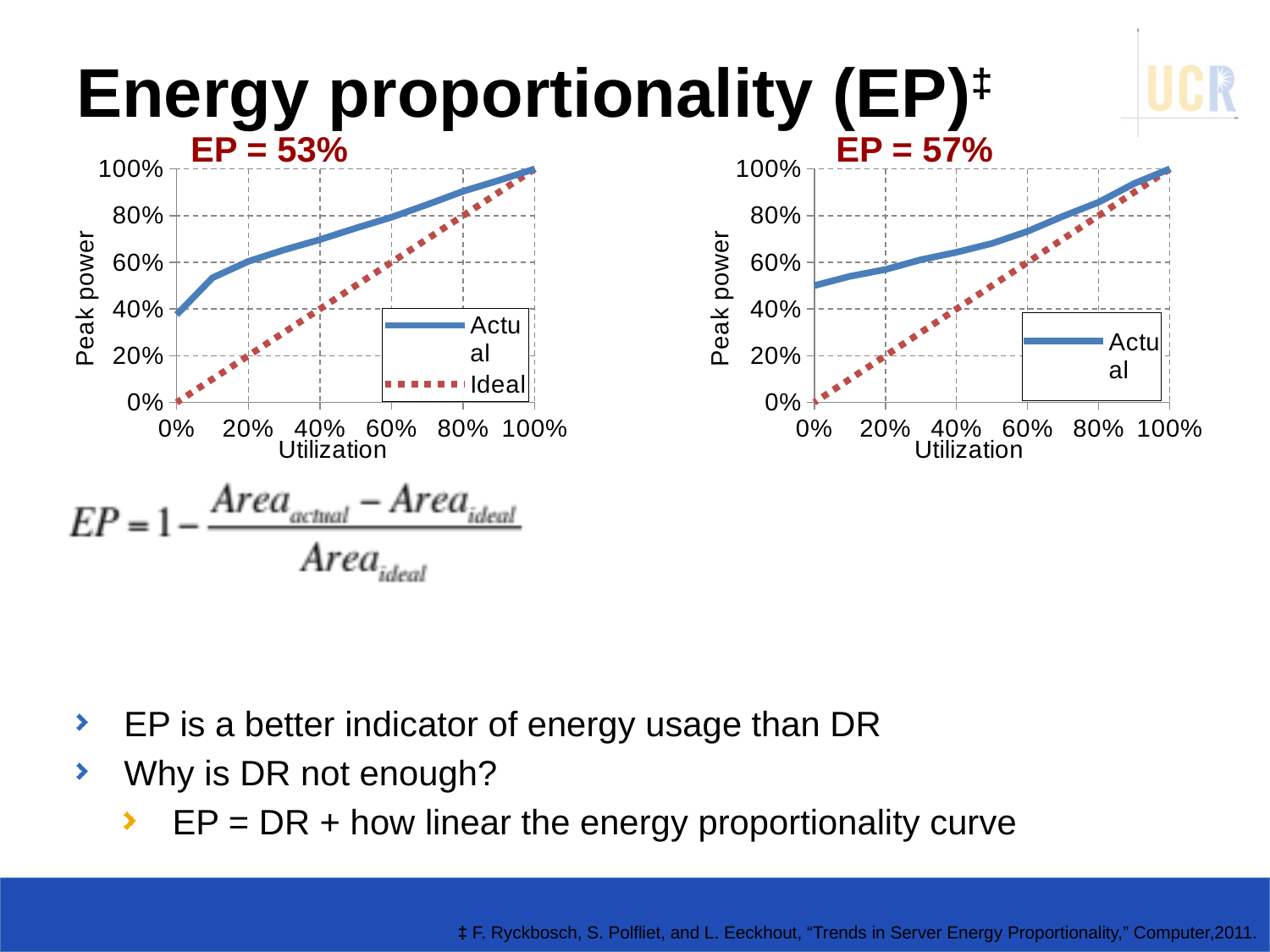
In the left chart (EP = 53%), what is the Ideal peak power at 0% utilization? 0% In the right chart (EP = 57%), is the Actual peak power at 0% utilization greater or less than 40%? greater What is the y-axis label of the left chart (EP = 53%)? Peak power In the left chart (EP = 53%), at 40% utilization, which series has the higher peak power, Actual or Ideal? Actual In the left chart (EP = 53%), what is the Actual peak power at 100% utilization? 100% In the left chart (EP = 53%), is the Actual peak power at 0% utilization greater or less than 20%? greater In the left chart (EP = 53%), is the Actual peak power at 40% utilization greater or less than 60%? greater In the right chart (EP = 57%), how many series does the legend list? 1 In the right chart (EP = 57%), does the Actual peak power rise or fall as utilization increases? rise In the right chart (EP = 57%), what is the Actual peak power at 100% utilization? 100% In the left chart (EP = 53%), how many series does the legend list? 2 What type of chart is the left chart (EP = 53%)? line chart